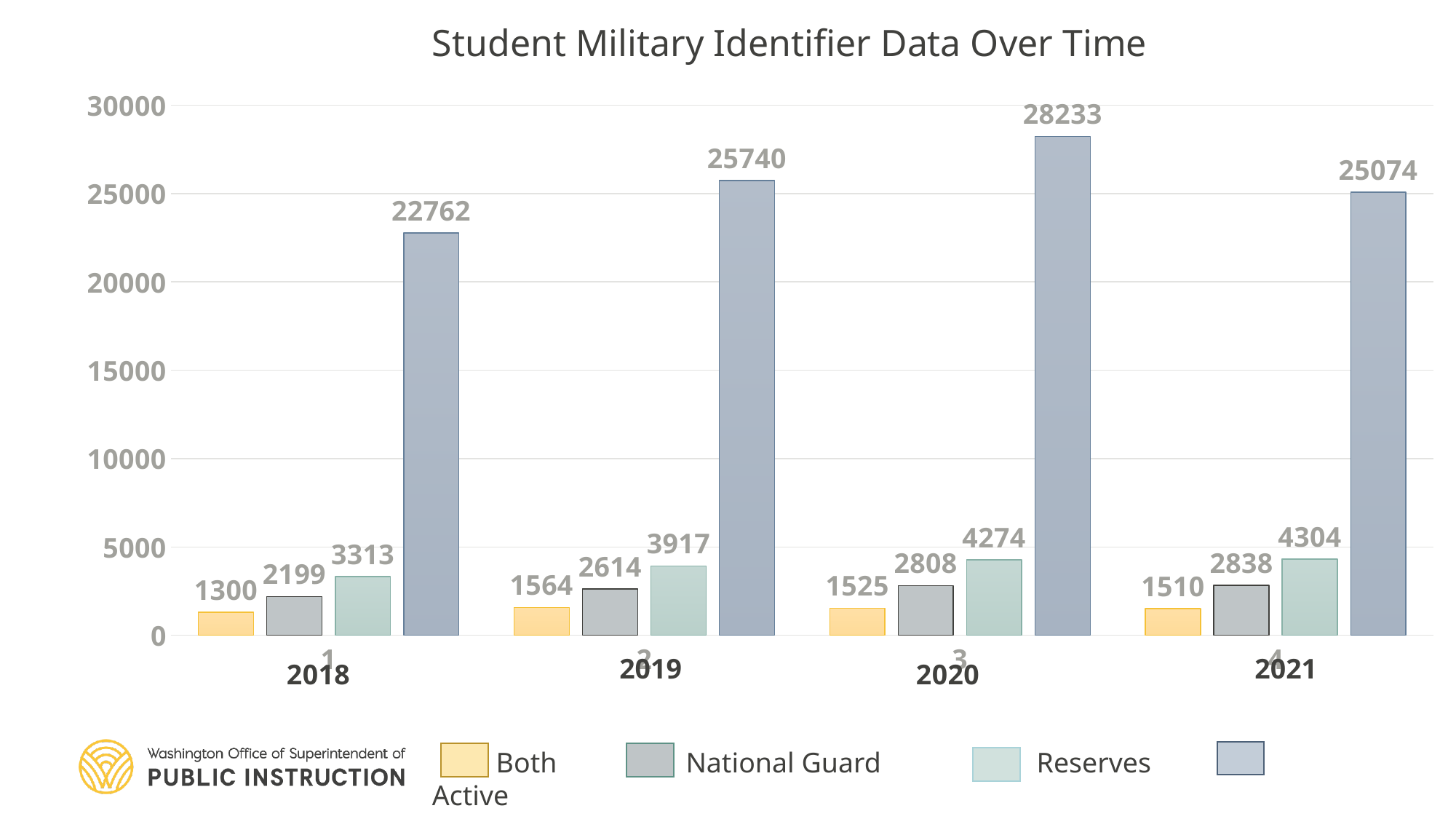
In which year is the tallest (blue-gray) bar at its highest value? 2020 In which year is the Both value lowest? 2018 What is the difference between the Reserves values for 2019 and 2018? 604 Which is larger, the Both value for 2020 or for 2021? 2020 What kind of chart is shown on the slide? Bar chart What is the value for National Guard in 2018? 2199 Does the National Guard value rise or fall from 2018 to 2021? Rise In which year is the Reserves value highest? 2021 What is the value for Reserves in 2020? 4274 What is the value for Both in 2019? 1564 What is the difference between the tallest (blue-gray) bar in 2020 and the tallest bar in 2021? 3159 How many years are shown on the x axis? 4